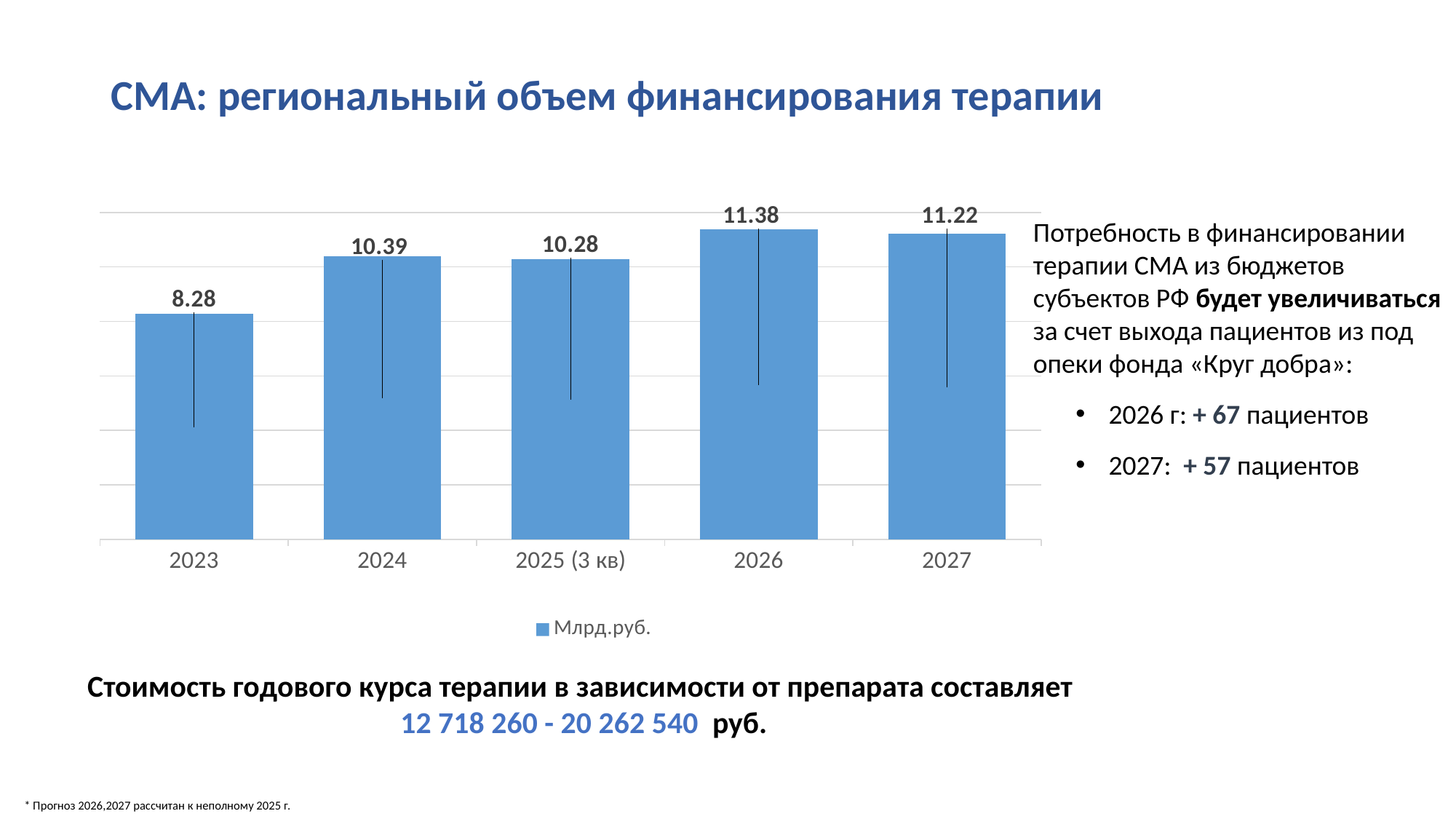
What is the value for 2023? 8.28 What is the value for 2026? 11.38 What kind of chart is this? bar chart How many categories are shown on the x axis? 5 What is the value for 2027? 11.22 What series name does the legend show? Млрд.руб. Which is larger, the value for 2024 or the value for 2025 (3 кв)? 2024 What is the value for 2025 (3 кв)? 10.28 What is the value for 2024? 10.39 Which year has the highest value? 2026 Which year has the lowest value? 2023 What is the difference between the values for 2026 and 2023? 3.10